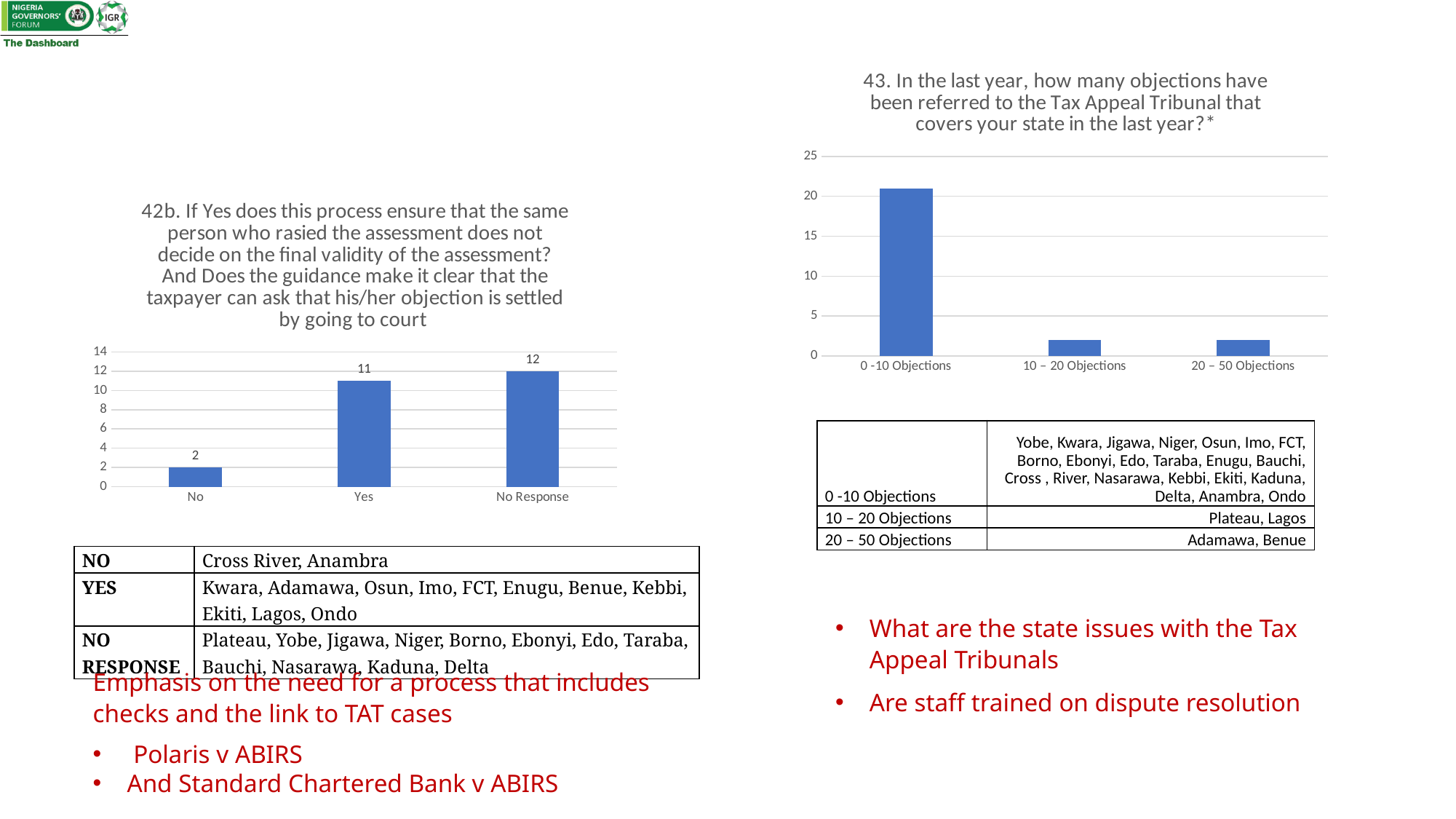
In the left chart (42b), what is the value for "No Response"? 12 What kind of chart is the right chart (43)? bar chart In the left chart (42b), which category has the lowest value? No In the right chart (43), is the value for "0 -10 Objections" greater or less than 20? greater In the left chart (42b), what is the difference between the values for "No Response" and "No"? 10 How many categories are shown on the x axis of the right chart (43)? 3 In the left chart (42b), what is the value for "Yes"? 11 In the right chart (43), is the value for "10 – 20 Objections" greater or less than 5? less How many categories are shown in the left chart (42b)? 3 In the left chart (42b), what is the value for "No"? 2 In the right chart (43), which category has the highest value? 0 -10 Objections In the left chart (42b), which is larger, the value for "Yes" or the value for "No"? Yes